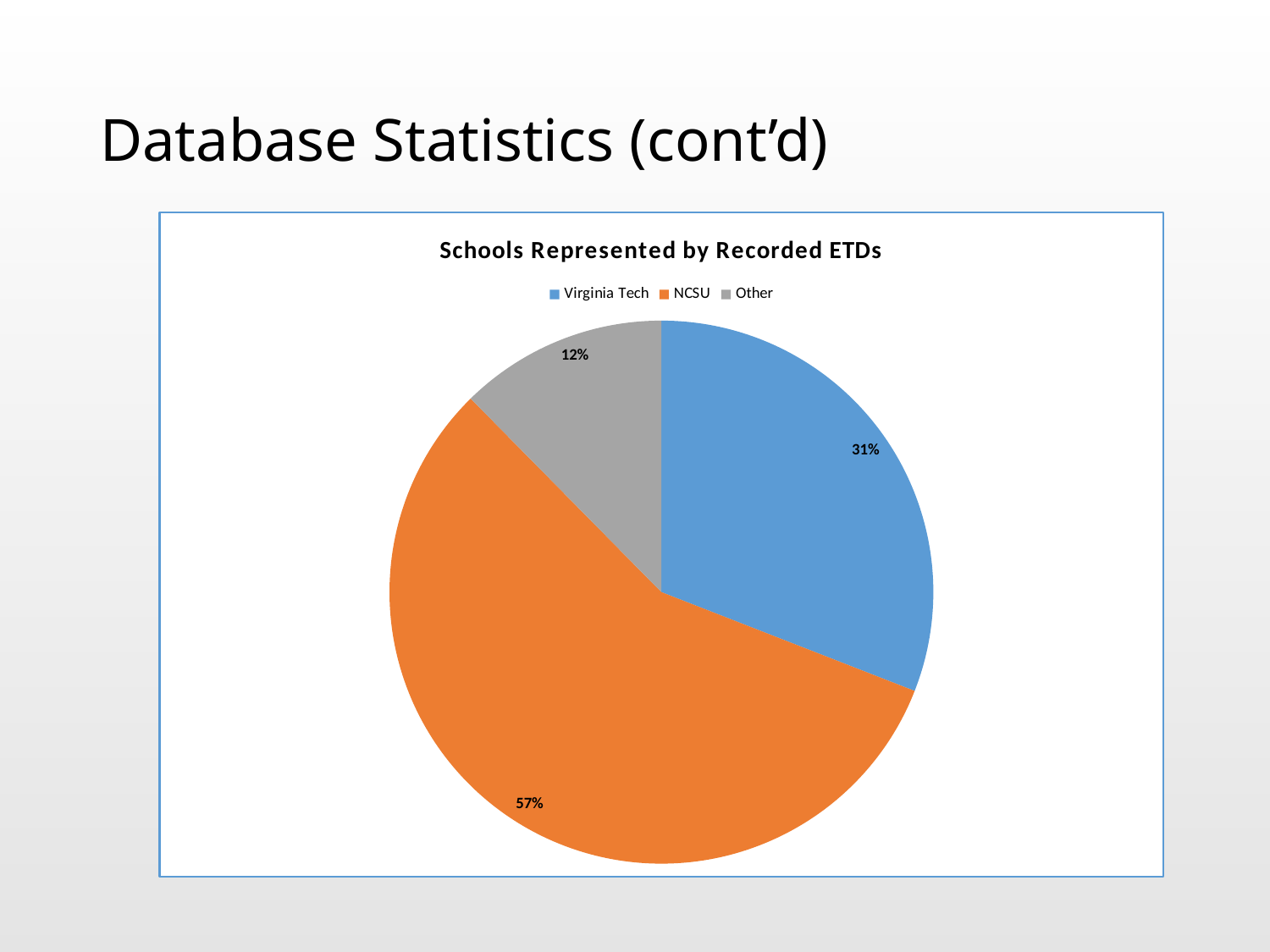
What share of the pie does Virginia Tech represent? 31% What is the title of the chart? Schools Represented by Recorded ETDs Which is larger, the share for Virginia Tech or the share for Other? Virginia Tech What share of the pie does Other represent? 12% Which school has the largest share of recorded ETDs? NCSU Which category has the smallest share of recorded ETDs? Other What type of chart is shown on the slide? pie chart What is the difference in percentage points between NCSU and Virginia Tech? 26 What colour is the NCSU slice? orange How many entries does the legend list? 3 How many slices does the pie chart have? 3 What share of the pie does NCSU represent? 57%